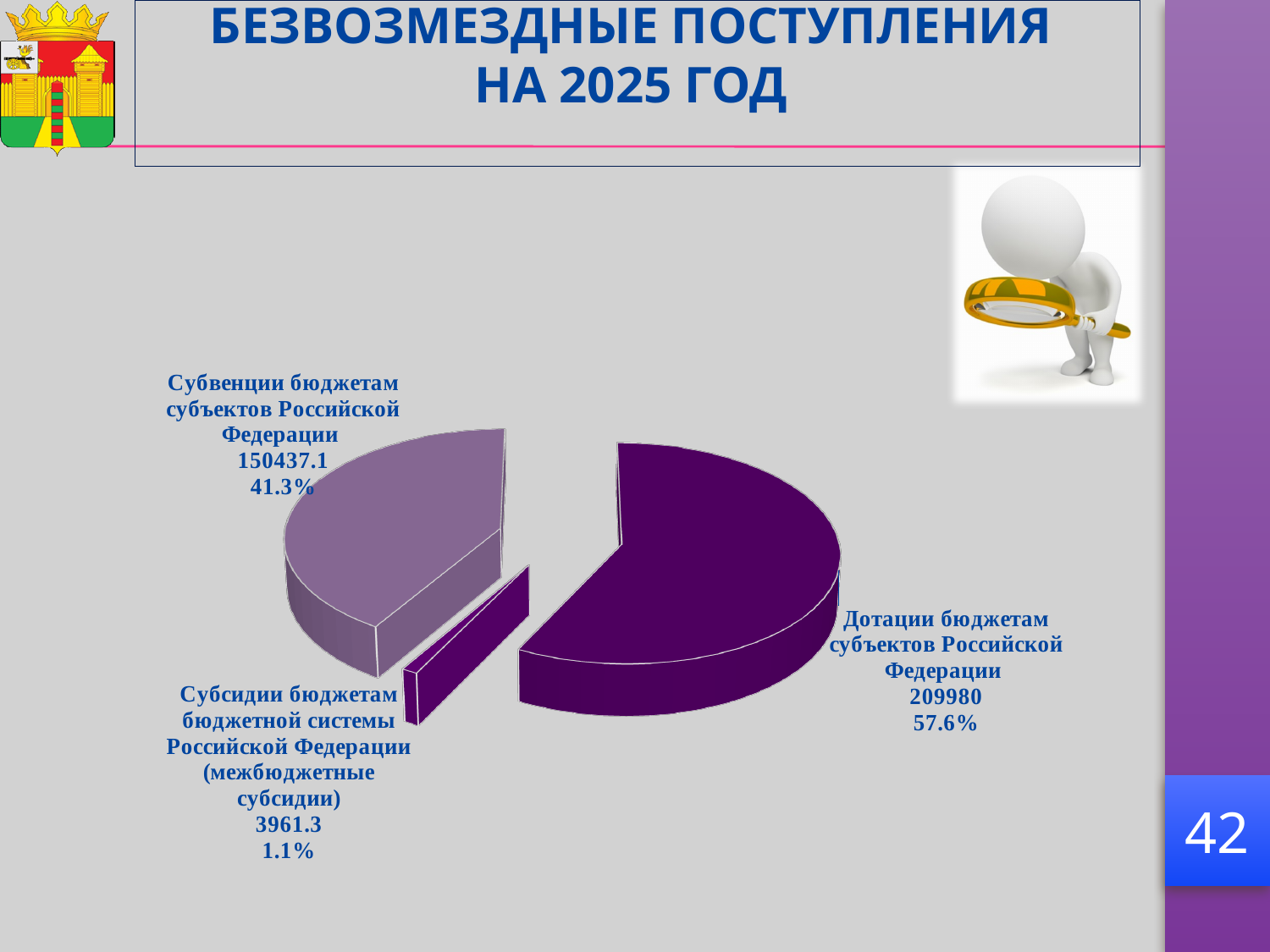
What is the difference between the values for Дотации and Субвенции? 59542.9 What is the title of the slide containing the pie chart? БЕЗВОЗМЕЗДНЫЕ ПОСТУПЛЕНИЯ НА 2025 ГОД What share of the pie is Субвенции бюджетам субъектов Российской Федерации? 41.3% What is the value for Субвенции бюджетам субъектов Российской Федерации? 150437.1 What is the value for Субсидии бюджетам бюджетной системы Российской Федерации (межбюджетные субсидии)? 3961.3 What share of the pie is Дотации бюджетам субъектов Российской Федерации? 57.6% Which category has the smallest slice of the pie? Субсидии бюджетам бюджетной системы Российской Федерации (межбюджетные субсидии) How many slices does the pie chart have? 3 What is the value for Дотации бюджетам субъектов Российской Федерации? 209980 Which category has the largest slice of the pie? Дотации бюджетам субъектов Российской Федерации What kind of chart is shown on the slide? Pie chart Which is larger, the value for Субвенции or the value for Субсидии? Субвенции